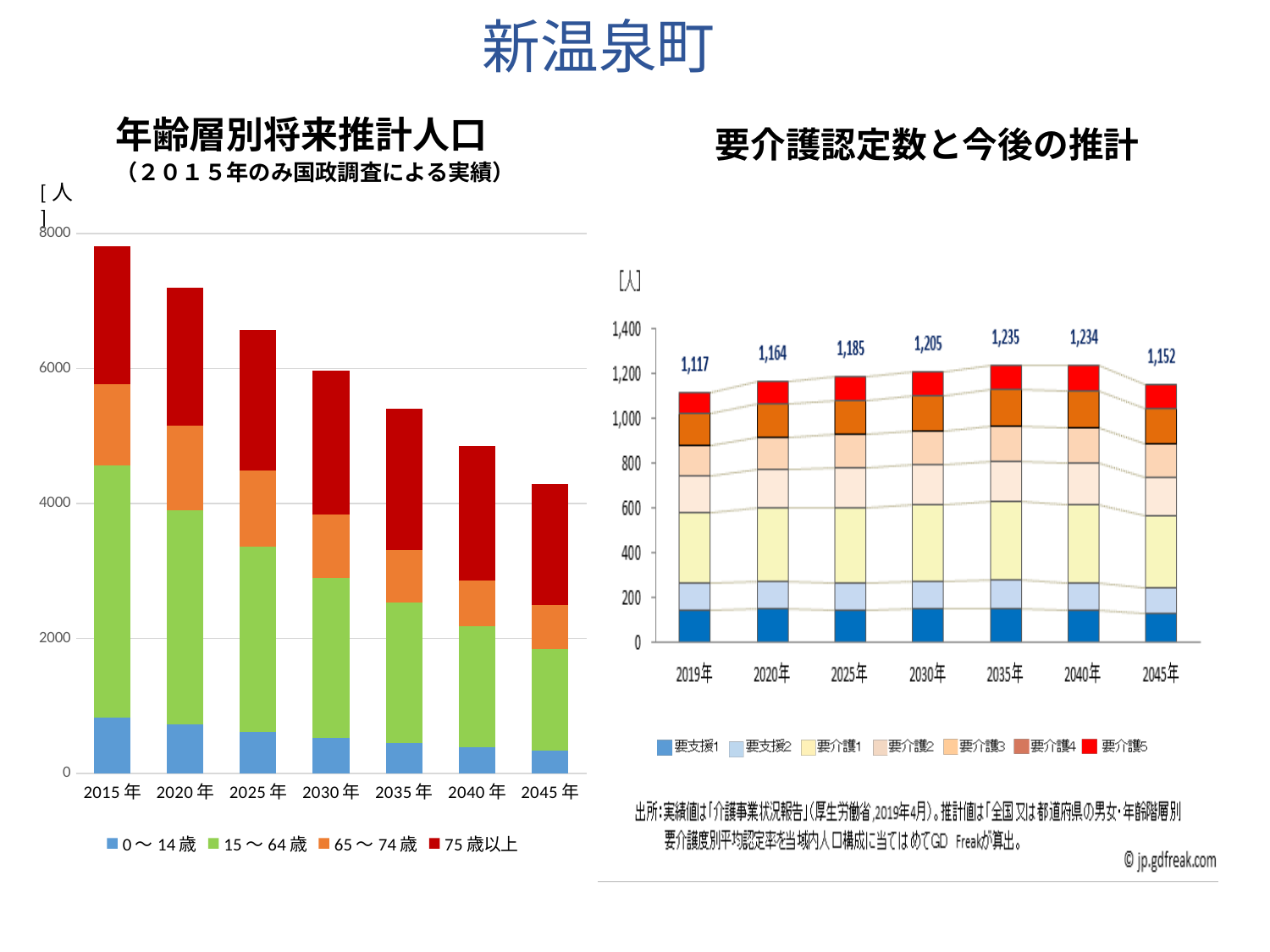
In the 要介護認定数と今後の推計 chart, which is larger, the total for 2020年 or the total for 2045年? 2020年 In the 要介護認定数と今後の推計 chart, what is the total value for 2019年? 1,117 How many series does the legend of the 年齢層別将来推計人口 chart list? 4 How many years are shown on the x axis of the 年齢層別将来推計人口 chart? 7 How many series does the legend of the 要介護認定数と今後の推計 chart list? 7 In the 要介護認定数と今後の推計 chart, which year has the highest total? 2035年 In the 要介護認定数と今後の推計 chart, what is the total value for 2045年? 1,152 In the 年齢層別将来推計人口 chart, do the total bar heights rise or fall from 2015年 to 2045年? fall In the 年齢層別将来推計人口 chart, is the total for 2015年 greater or less than 6000? greater What kind of chart is the 年齢層別将来推計人口 chart? stacked bar chart In the 要介護認定数と今後の推計 chart, what is the difference between the totals for 2035年 and 2019年? 118 In the 要介護認定数と今後の推計 chart, which year has the lowest total? 2019年